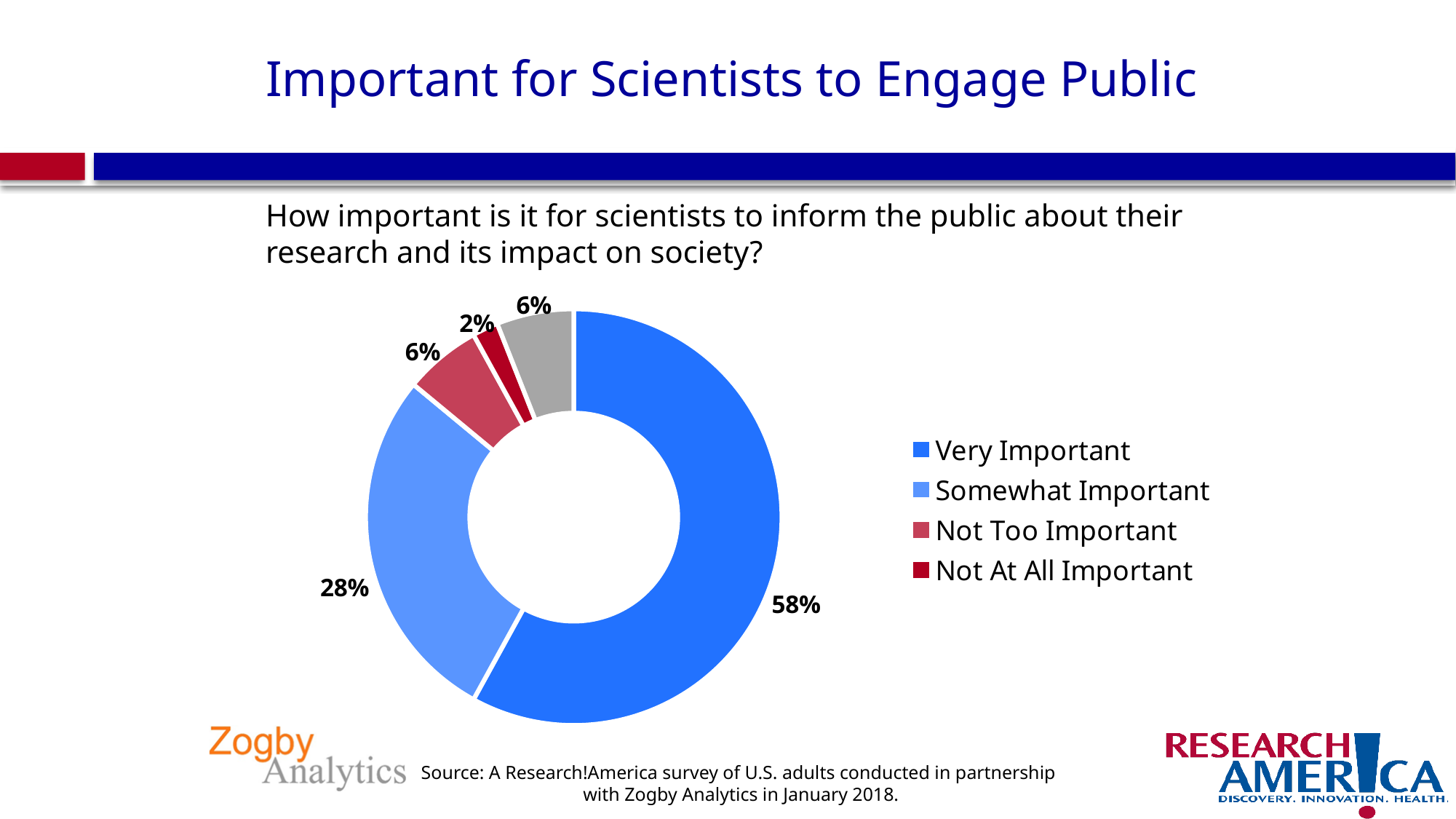
How many categories are listed in the chart's legend? 4 How many slices does the pie chart have? 5 Which is larger, the share for Somewhat Important or the share for Not Too Important? Somewhat Important What is the title of the slide containing the chart? Important for Scientists to Engage Public How many percentage points larger is the Very Important share than the Somewhat Important share? 30 percentage points What type of chart is shown on the slide? Doughnut chart What percentage of respondents said it is Very Important for scientists to inform the public about their research? 58% What share of respondents said Not Too Important? 6% What percentage of respondents chose Somewhat Important? 28% Which response category has the largest share of the pie? Very Important What percentage of respondents said Not At All Important? 2% Which legend category has the smallest share of the pie? Not At All Important